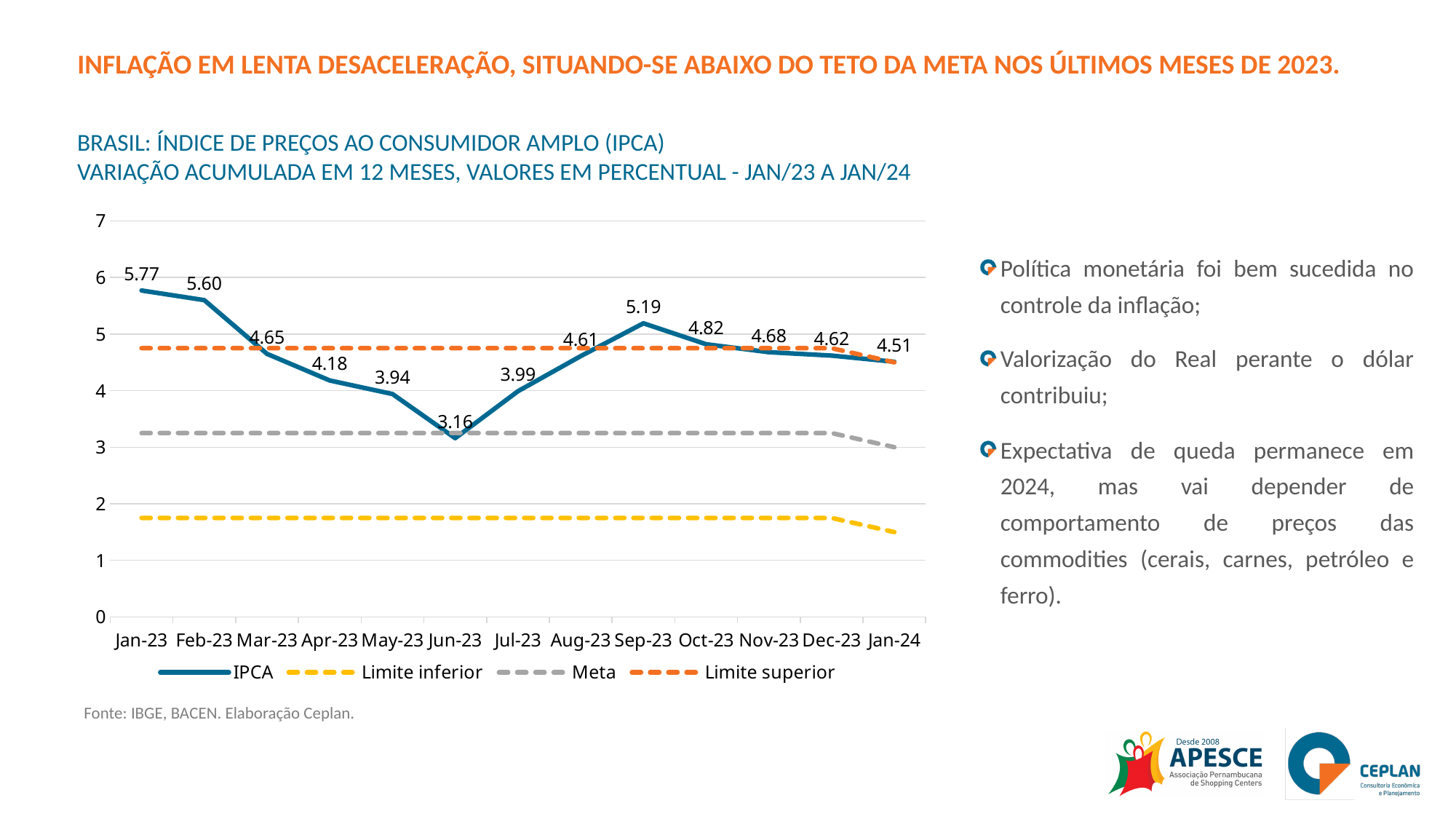
In which month is the IPCA value lowest? Jun-23 How many months are shown on the x axis? 13 What is the IPCA value for Jan-24? 4.51 What is the IPCA value for Sep-23? 5.19 What is the IPCA value for Jun-23? 3.16 In which month is the IPCA value highest? Jan-23 What is the difference between the IPCA values for Jan-23 and Jun-23? 2.61 Which is larger, the IPCA value for Sep-23 or for Oct-23? Sep-23 What kind of chart is shown? line chart How many series does the legend list? 4 What is the IPCA value for Jan-23? 5.77 Is the Limite inferior value for Jan-23 greater or less than 2? less